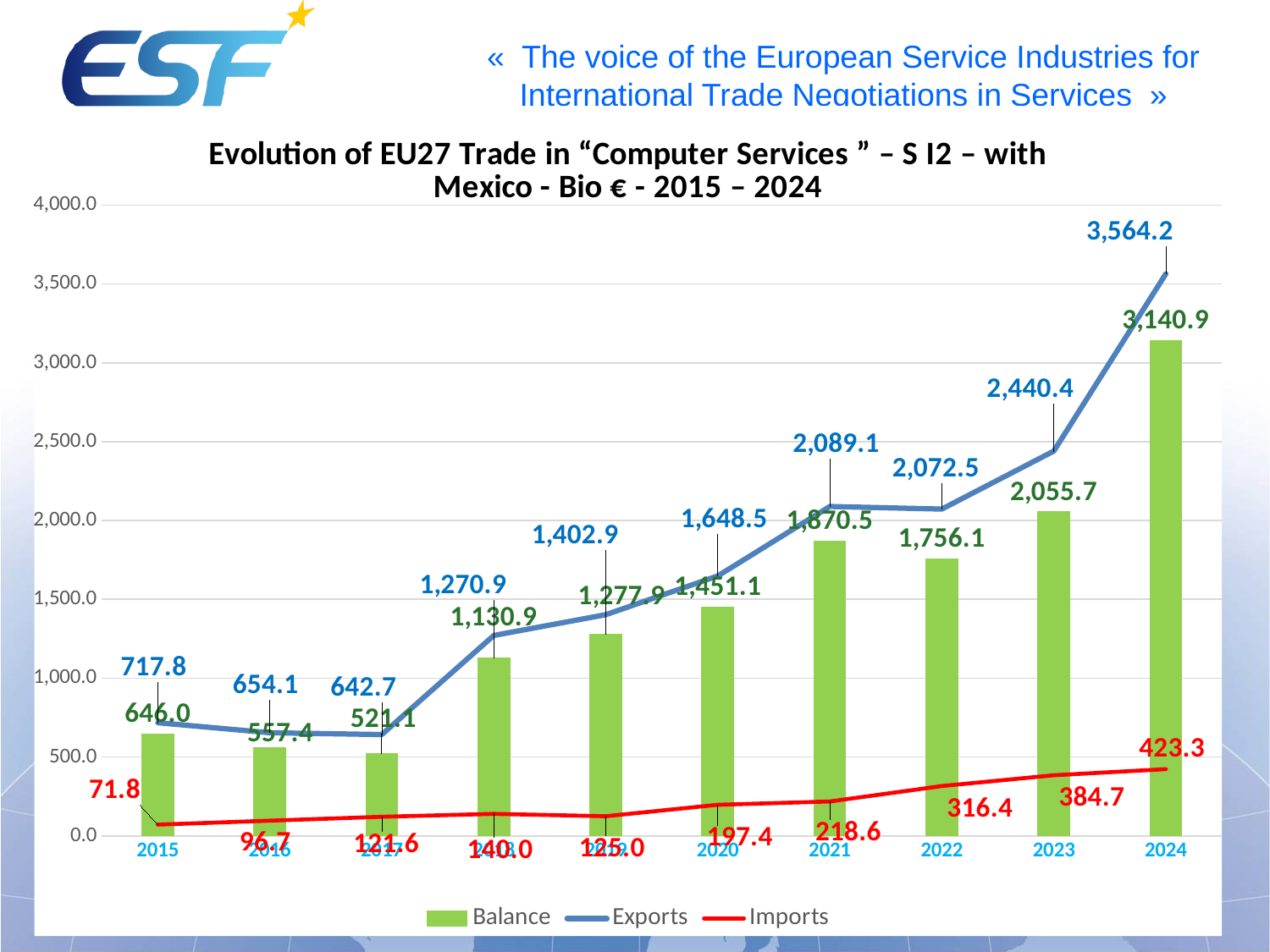
What is the difference between Exports and Imports in 2024? 3,140.9 In which year is the Balance lowest? 2017 Is the Balance value for 2020 greater or less than 1,500.0? less What is the value of Balance in 2023? 2,055.7 What kind of chart is this? Combined bar and line chart How many series does the legend list? 3 Do Imports rise or fall from 2019 to 2024? Rise What is the value of Imports in 2022? 316.4 How many years are shown on the x axis? 10 In which year are Exports highest? 2024 Which year has higher Exports, 2021 or 2022? 2021 What is the value of Exports in 2024? 3,564.2